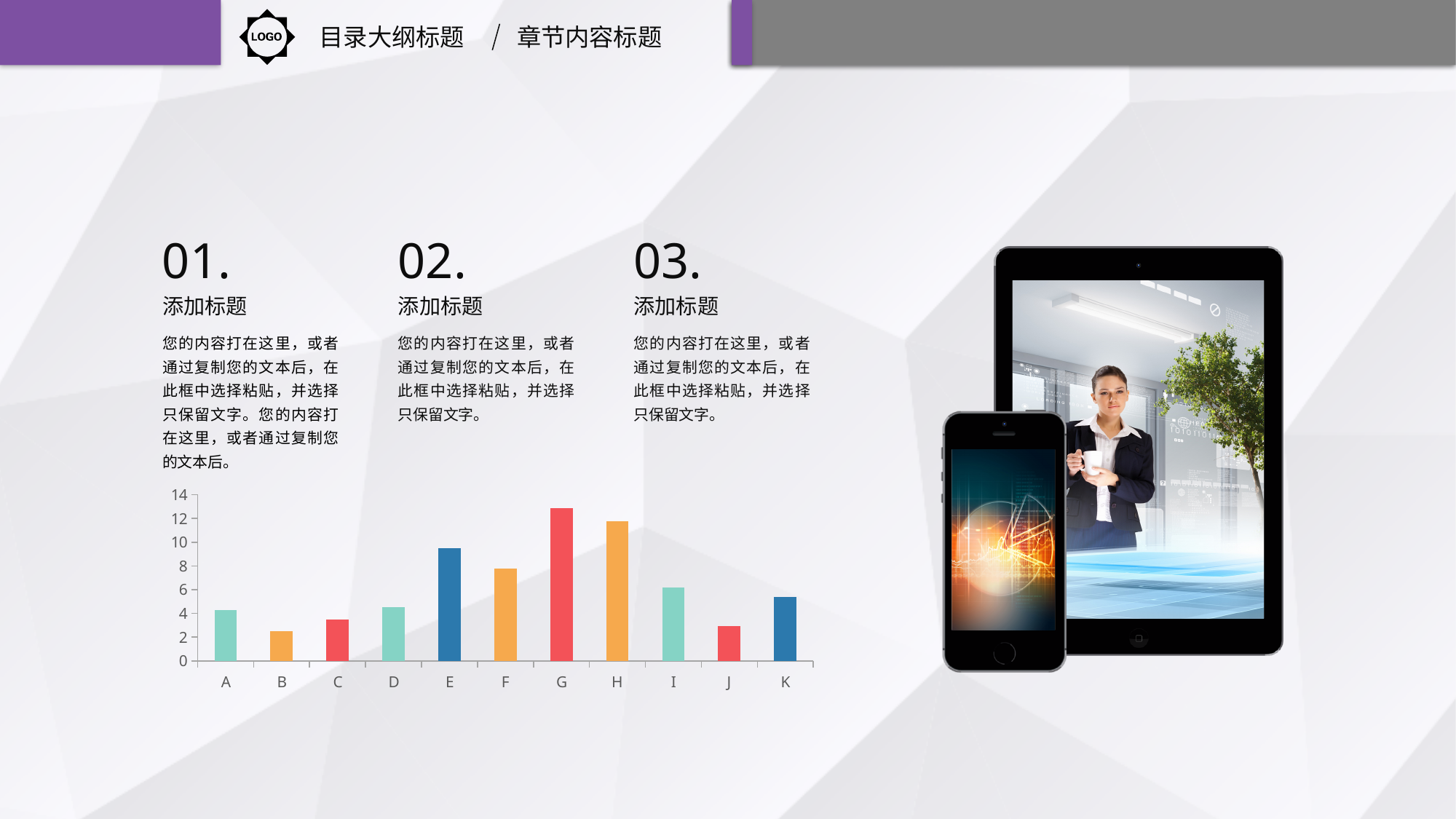
Is the value for K greater or less than 4? greater Is the value for H greater or less than 10? greater Which is larger, the value for C or the value for D? D Which category has the highest bar in the chart? G Which is larger, the value for G or the value for H? G What is the highest value shown on the y axis of the chart? 14 Is the value for E greater or less than 8? greater What kind of chart is shown on the slide? bar chart Which is larger, the value for E or the value for F? E How many categories are plotted on the x axis of the bar chart? 11